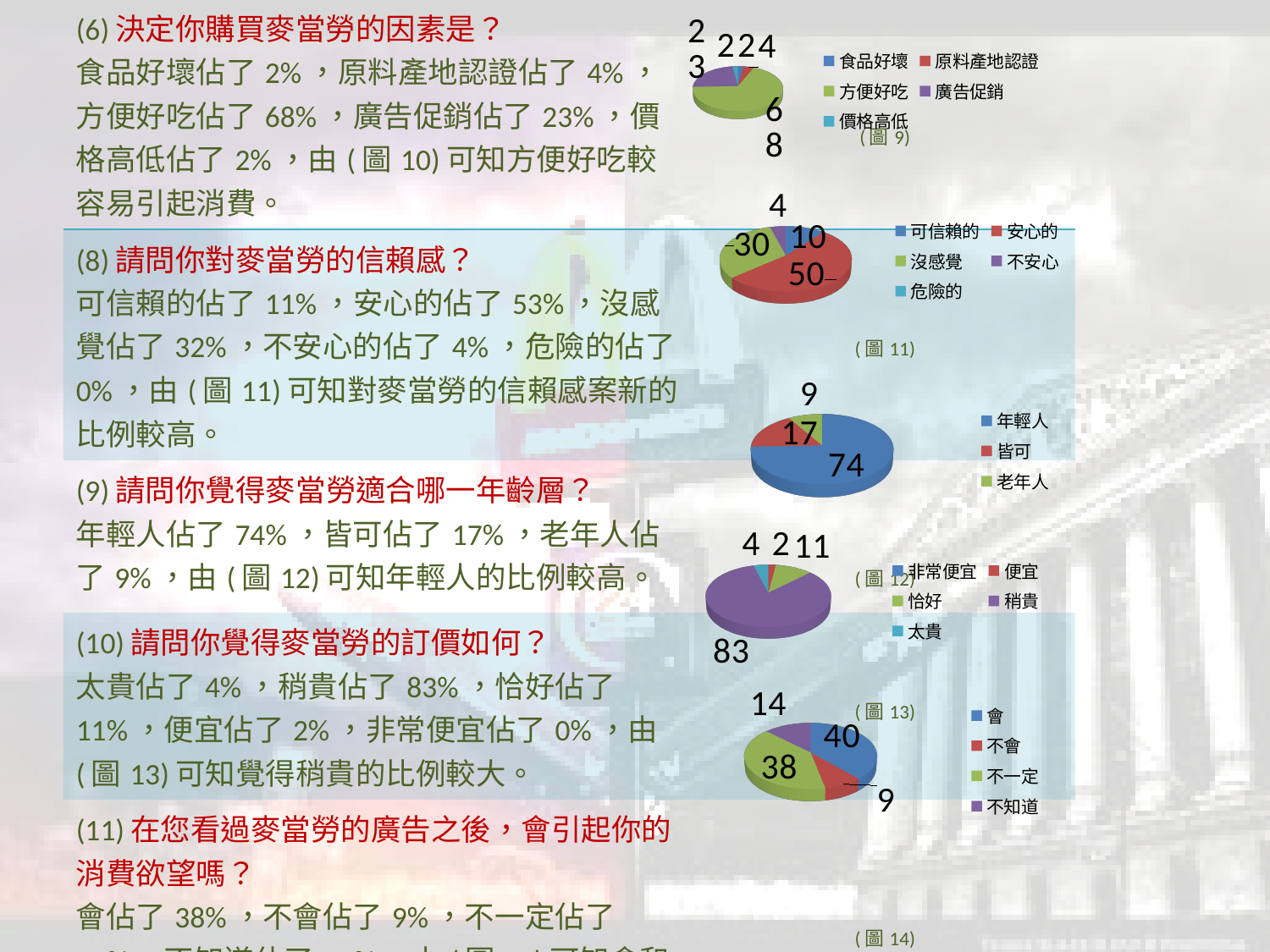
In the pie chart labelled (圖 13), which category has the largest slice? 稍貴 What type of chart is the chart labelled (圖 14)? pie chart How many entries does the legend of the pie chart labelled (圖 12) list? 3 In the pie chart labelled (圖 12), which category has the largest slice? 年輕人 In the pie chart labelled (圖 12), what value is shown for 年輕人? 74 In the pie chart labelled (圖 13), what value is shown for 稍貴? 83 In the pie chart labelled (圖 12), what is the difference between the values for 年輕人 and 皆可? 57 In the pie chart labelled (圖 12), which category has the smallest slice? 老年人 In the pie chart labelled (圖 14), what value is shown for 不會? 9 How many entries does the legend of the pie chart labelled (圖 13) list? 5